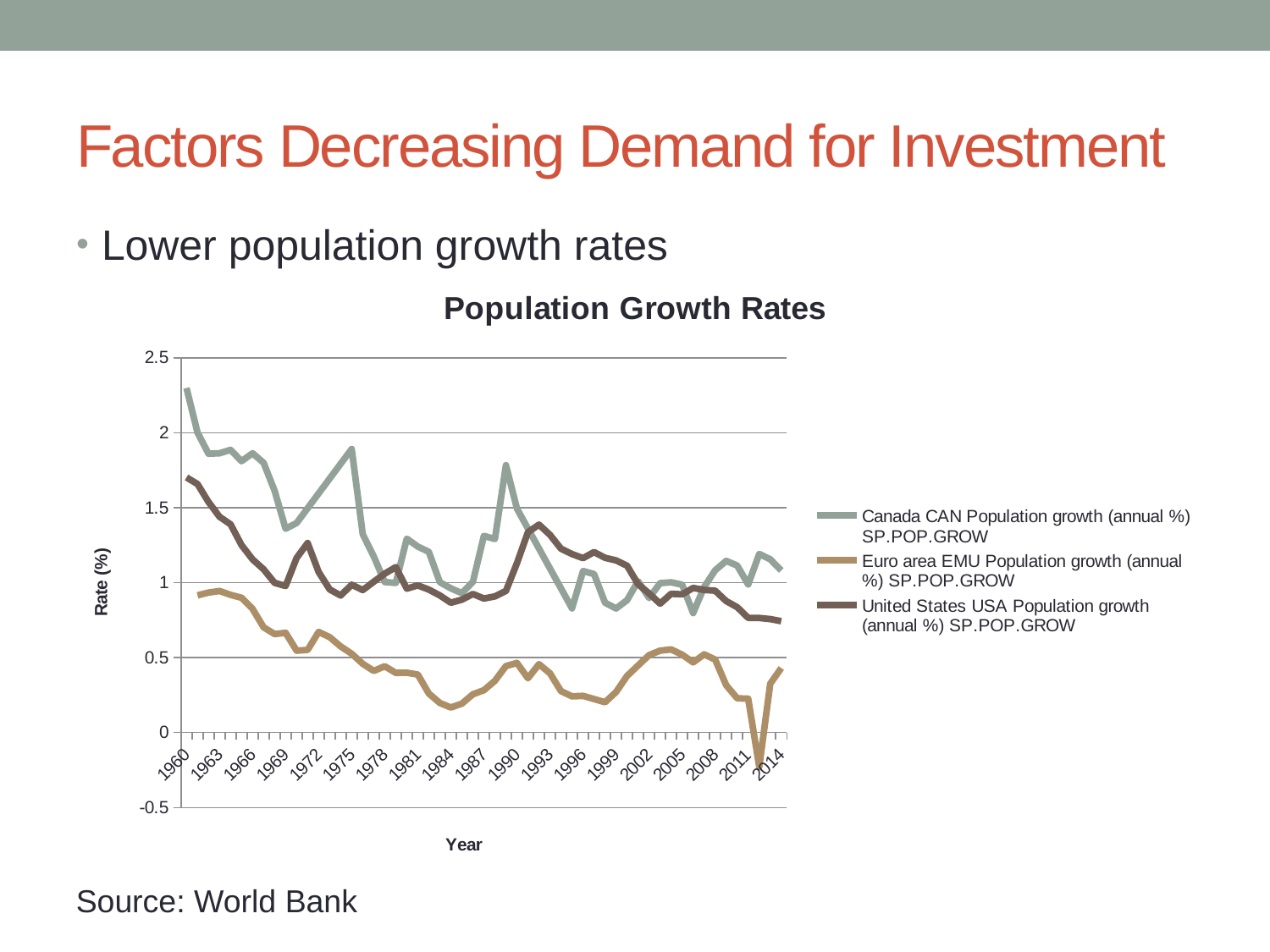
Is the United States population growth rate in 2014 greater or less than 1? less How many series does the legend of the Population Growth Rates chart list? 3 What kind of chart is shown on the slide? Line chart Does the Euro area population growth rate generally rise or fall from 1960 to 1984? fall What is the title of the chart on the slide? Population Growth Rates Which series has the highest population growth rate in 1960? Canada Is the United States population growth rate in 1960 greater or less than 1.5? greater What is the label on the vertical axis of the chart? Rate (%) Is the Canada population growth rate in 1960 greater or less than 2? greater